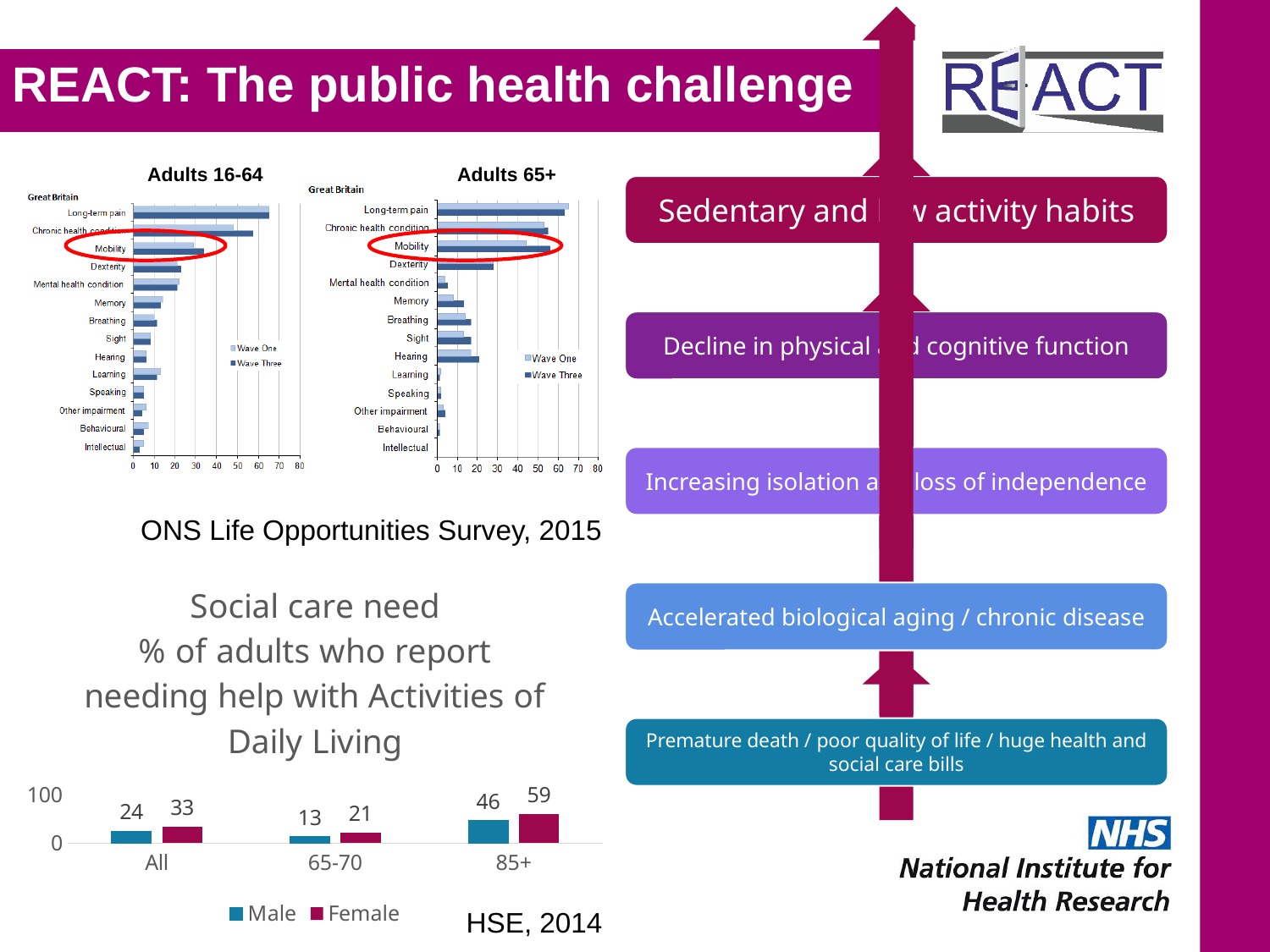
In the 'Social care need' chart, which age group has the lowest Male value? 65-70 In the 'Social care need' chart, what is the value for Male in the 65-70 group? 13 How many age groups are shown on the x axis of the 'Social care need' chart? 3 What kind of chart is the 'Adults 65+' chart? Bar chart In the 'Social care need' chart, which is larger for the 65-70 group, Male or Female? Female In the 'Social care need' chart, which age group has the highest Female value? 85+ In the 'Adults 65+' chart, is the Wave Three value for Mobility greater or less than 40? greater In the 'Social care need' chart, what is the value for Female in the 'All' group? 33 In the 'Social care need' chart, what is the difference between the Female and Male values for the 85+ group? 13 In the 'Social care need' chart, what percentage of females aged 85+ report needing help with Activities of Daily Living? 59 How many series does the legend of the 'Social care need' chart list? 2 In the 'Adults 16-64' chart, which category has the longest bars? Long-term pain